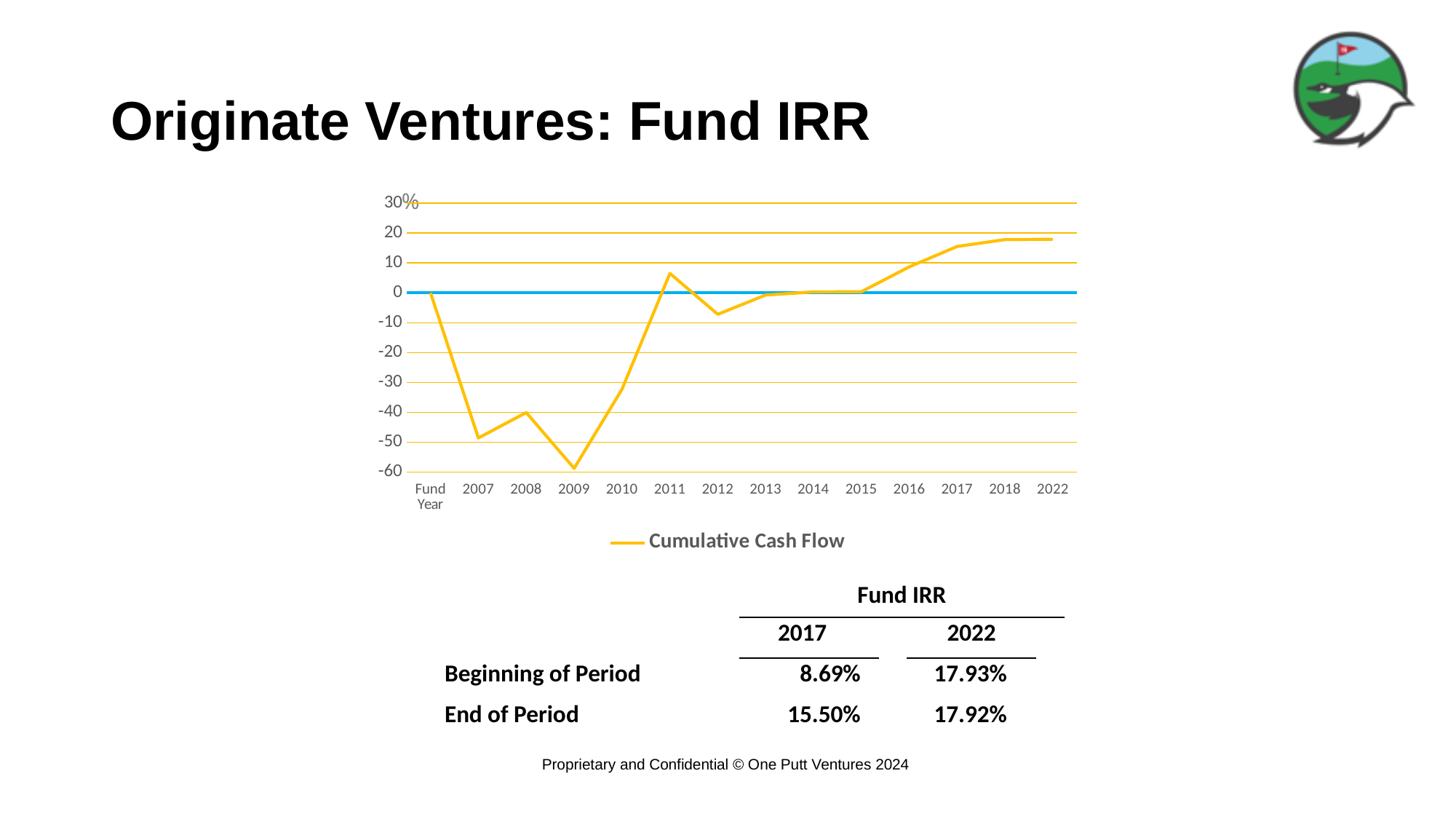
Is the Cumulative Cash Flow value for 2017 greater or less than 10? greater How many series does the chart's legend list? 1 Does Cumulative Cash Flow rise or fall from 2012 to 2018? Rise In which year does Cumulative Cash Flow reach its lowest value? 2009 What kind of chart is shown on the slide? Line chart Is the Cumulative Cash Flow value for 2009 greater or less than -50? less Which year has the higher Cumulative Cash Flow, 2011 or 2012? 2011 How many points are plotted along the x axis of the chart? 14 Which year has the higher Cumulative Cash Flow, 2007 or 2008? 2008 Is the Cumulative Cash Flow value for 2012 greater or less than 0? less What is the name of the series shown in the chart's legend? Cumulative Cash Flow